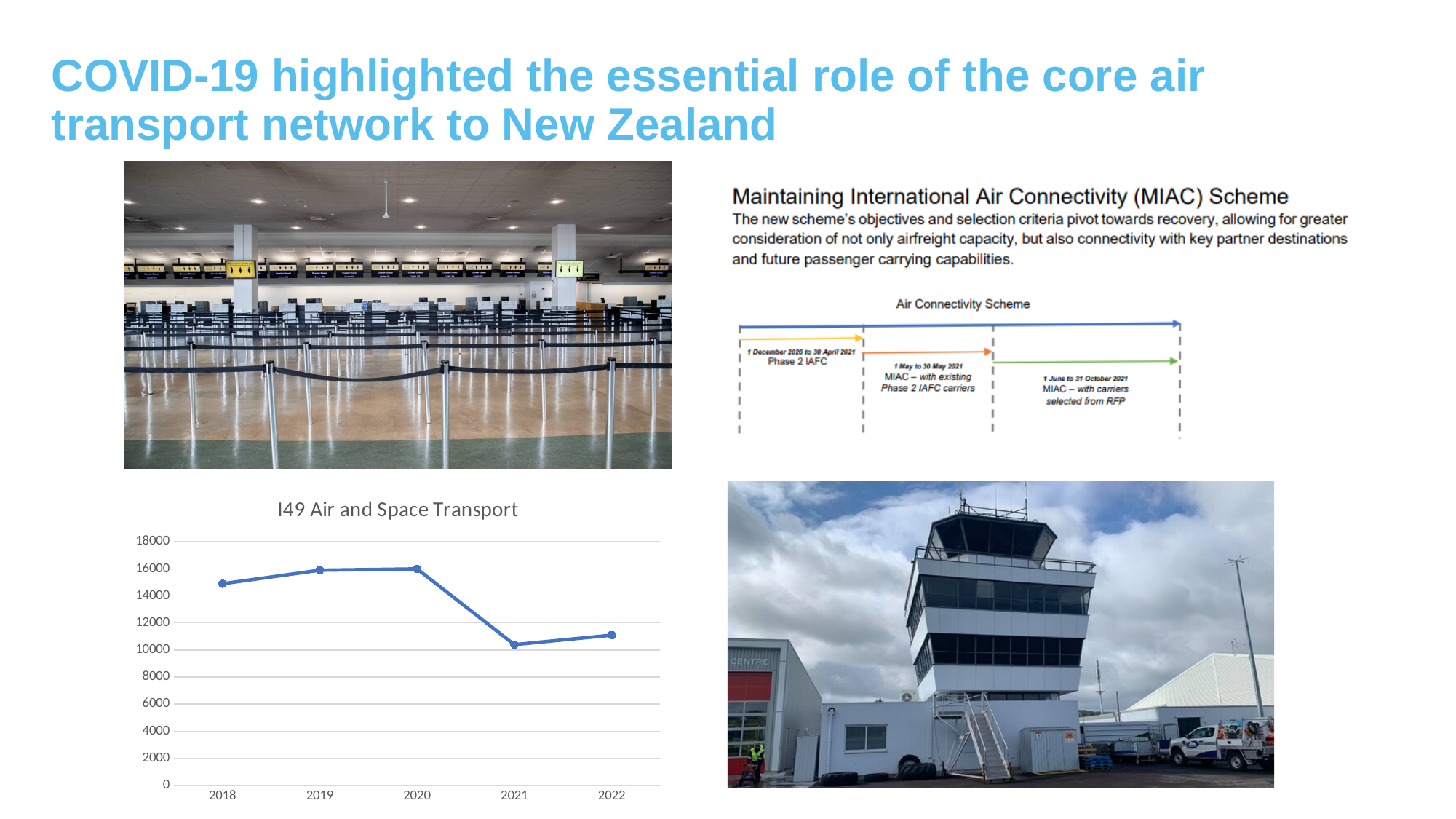
In the 'I49 Air and Space Transport' chart, is the value for 2021 greater or less than 12000? less What kind of chart is the 'I49 Air and Space Transport' chart? line chart In the 'I49 Air and Space Transport' chart, which year has the larger value, 2021 or 2022? 2022 In the 'I49 Air and Space Transport' chart, which year has the lowest value? 2021 In the 'I49 Air and Space Transport' chart, is the value for 2018 greater or less than 14000? greater What is the title of the chart on the slide? I49 Air and Space Transport How many years are plotted on the x axis of the 'I49 Air and Space Transport' chart? 5 In the 'I49 Air and Space Transport' chart, which year has the larger value, 2018 or 2021? 2018 In the 'I49 Air and Space Transport' chart, is the value for 2020 greater or less than 14000? greater In the 'I49 Air and Space Transport' chart, does the value rise or fall from 2020 to 2021? fall